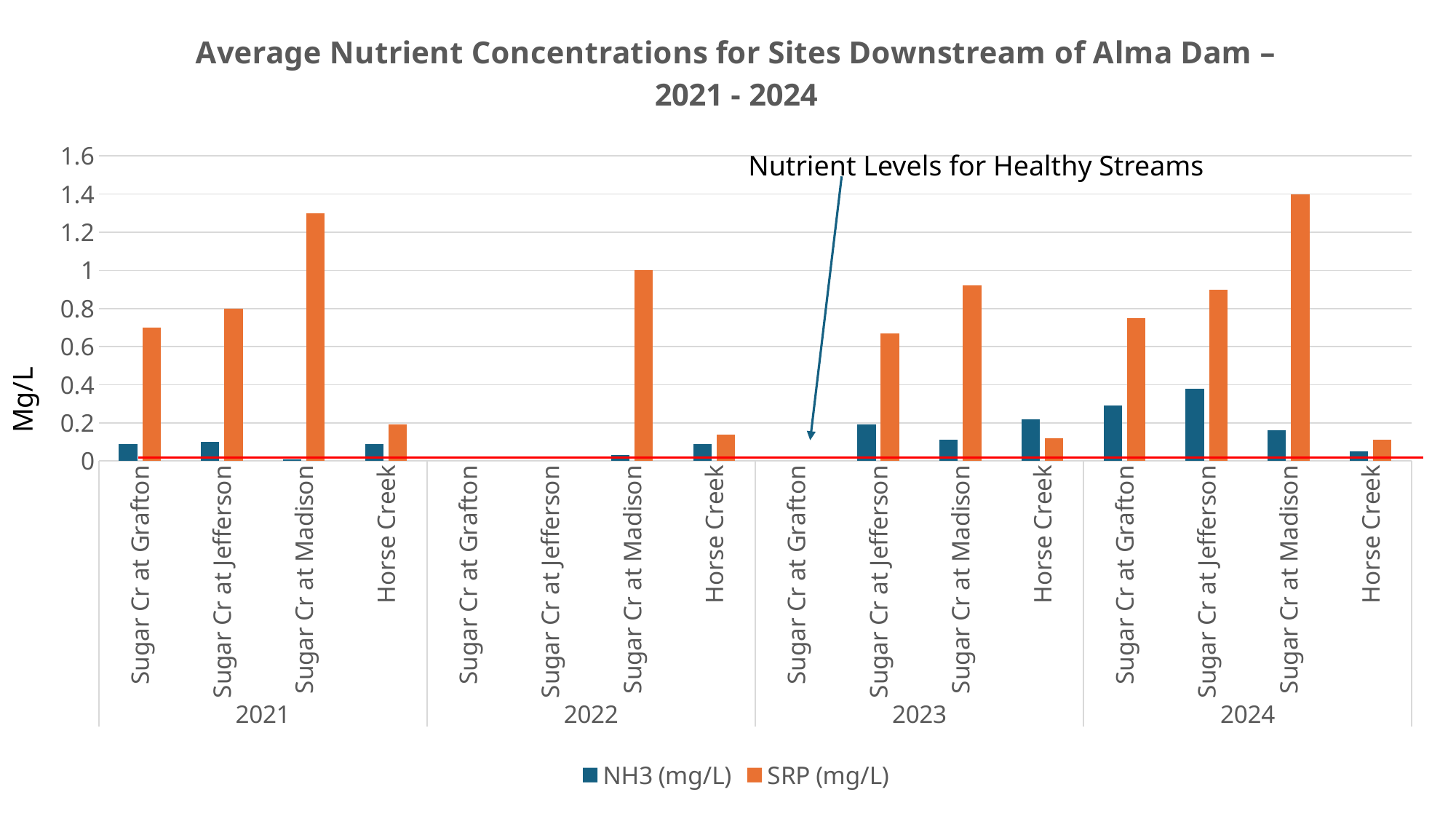
Is the SRP (mg/L) value for Sugar Cr at Madison in 2021 greater or less than 1.2? greater Which is larger: the SRP (mg/L) value for Sugar Cr at Madison in 2021 or in 2022? 2021 How many series does the legend list? 2 Which site and year has the highest NH3 (mg/L) value? Sugar Cr at Jefferson, 2024 What are the two series named in the legend? NH3 (mg/L) and SRP (mg/L) What kind of chart is shown on the slide? bar chart What does the label on the red horizontal line say? Nutrient Levels for Healthy Streams Is the SRP (mg/L) value for Sugar Cr at Grafton in 2021 greater or less than 0.8? less Is the NH3 (mg/L) value for Sugar Cr at Jefferson in 2024 greater or less than 0.2? greater How many years are shown along the x axis? 4 Which site and year has the highest SRP (mg/L) value? Sugar Cr at Madison, 2024 How many site categories are plotted in total across all years? 16